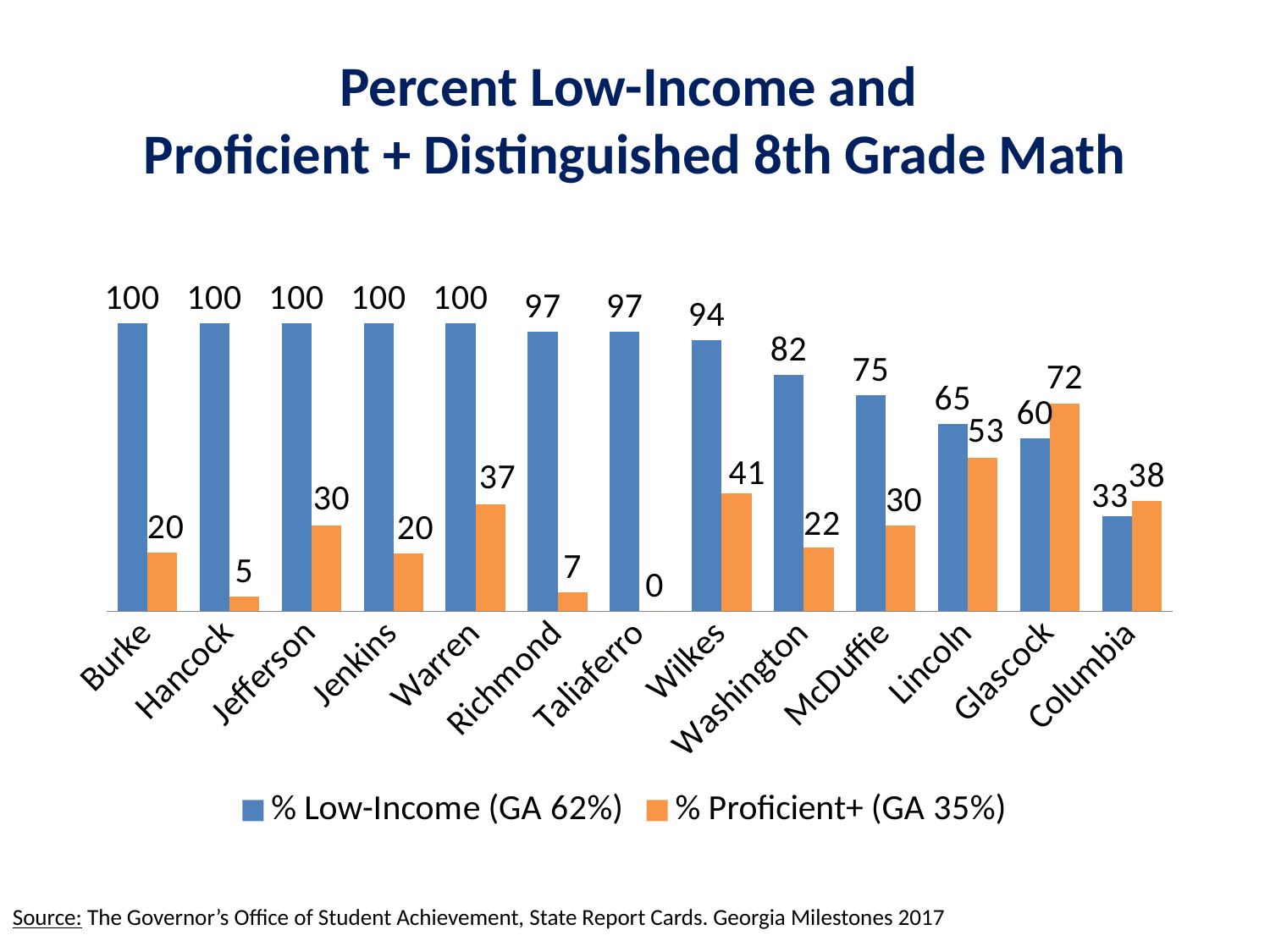
What is the difference between the % Low-Income and % Proficient+ values for Wilkes? 53 Which is larger for Columbia: the % Low-Income value or the % Proficient+ value? % Proficient+ What kind of chart is shown on the slide? Bar chart Do the % Low-Income values generally rise or fall from left to right along the x axis? Fall What Georgia statewide percentage is given in the legend for % Proficient+? 35% What is the % Proficient+ value for Glascock? 72 What is the % Low-Income value for Washington? 82 How many counties are shown on the x axis? 13 How many series does the legend list? 2 What is the % Proficient+ value for Taliaferro? 0 Which county has the lowest % Low-Income value? Columbia Which county has the highest % Proficient+ value? Glascock